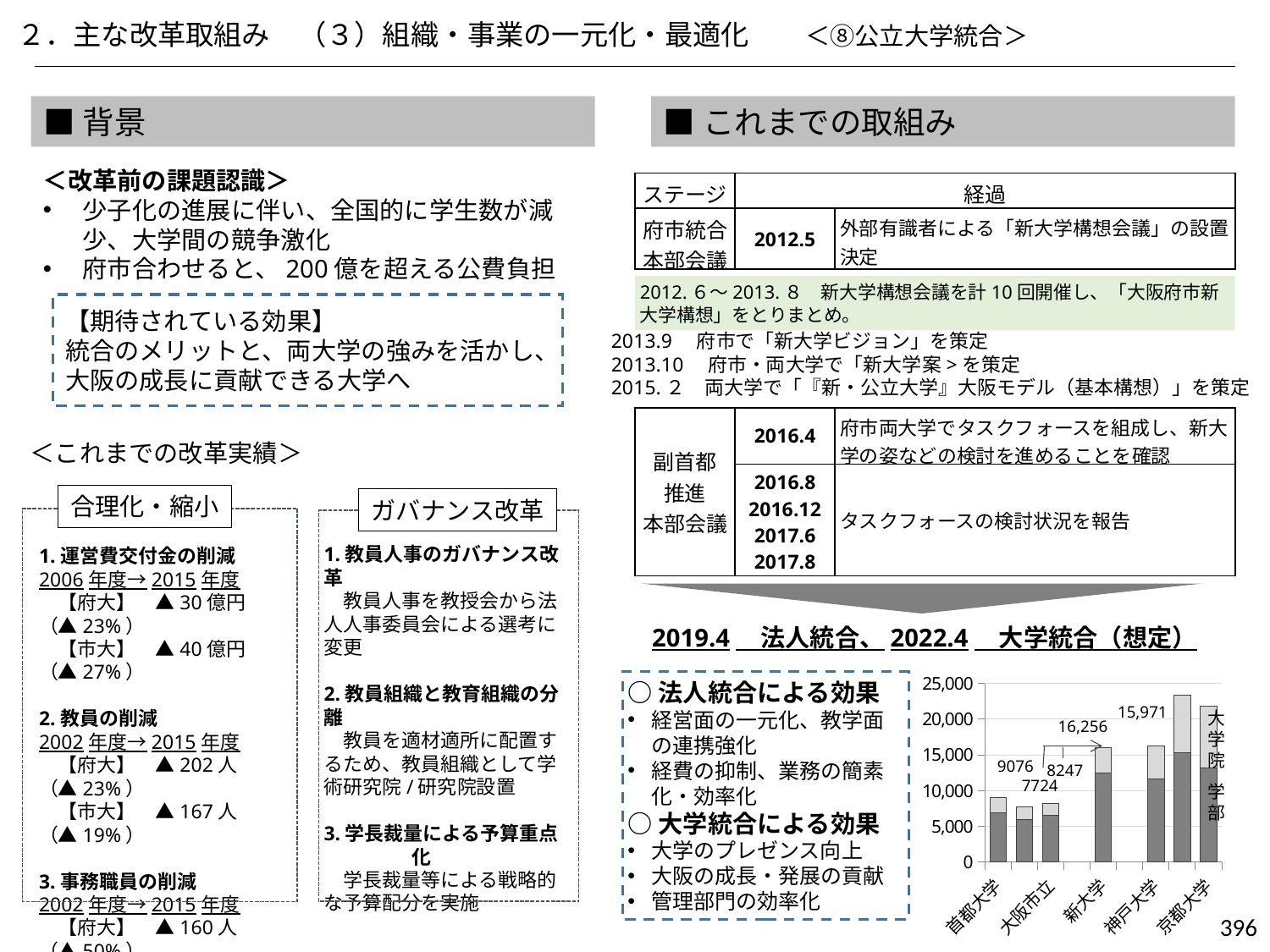
Is the value for 京都大学 greater or less than 20,000? greater What is the difference between the labelled values for 新大学 and 神戸大学? 285 What kind of chart is shown at the bottom right of the slide? Stacked bar chart Which is larger in the bar chart, the value for 新大学 or for 神戸大学? 神戸大学 What is the maximum value shown on the vertical axis of the bar chart? 25,000 What is the labelled value for 神戸大学 in the bar chart? 16,256 Is the value for 首都大学 greater or less than 10,000? less What is the labelled value for 首都大学 in the bar chart? 9076 What is the labelled value for 新大学 in the bar chart? 15,971